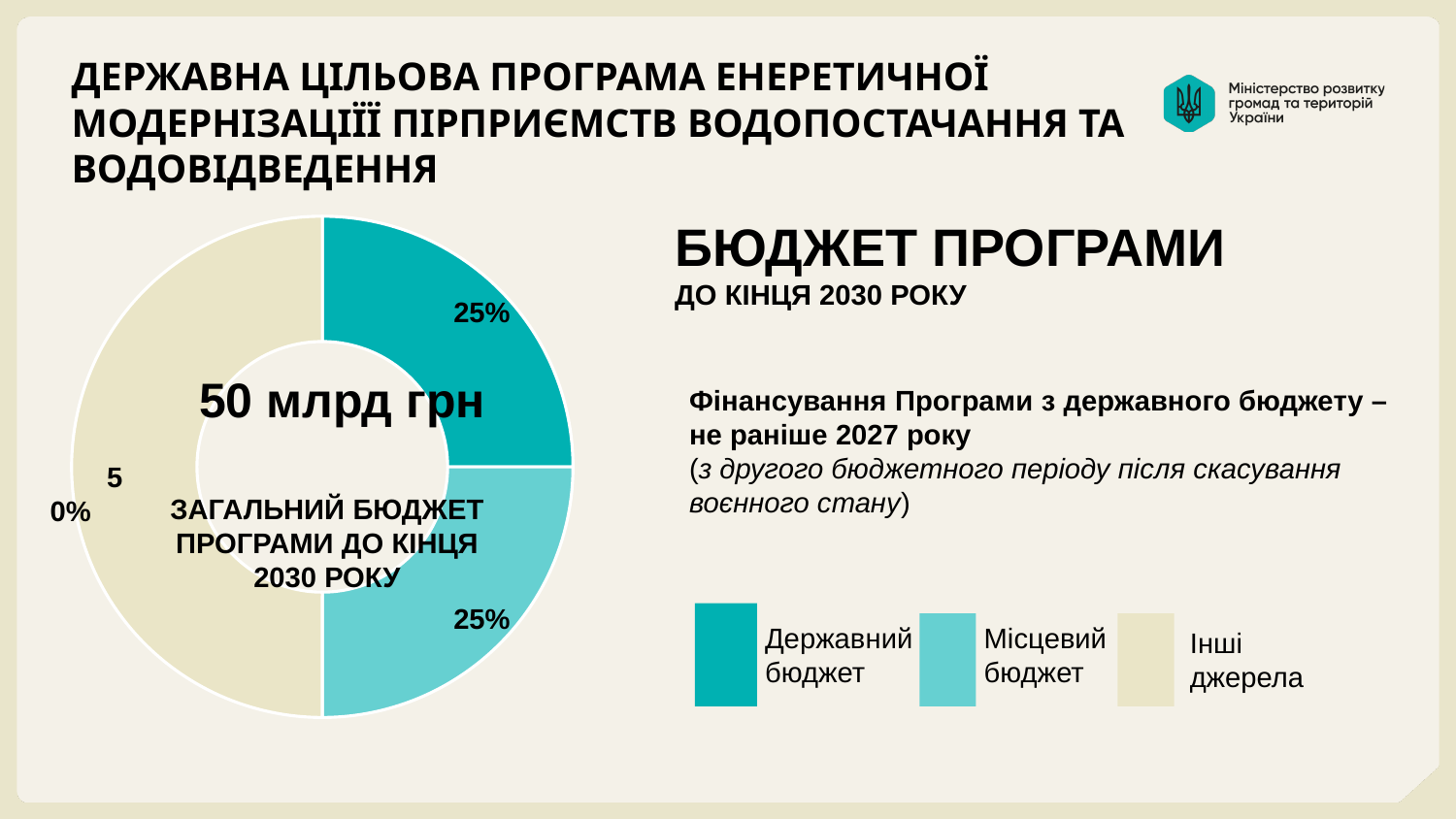
What is the combined share of Державний бюджет and Місцевий бюджет? 50% Which is larger: the share for Інші джерела or the share for Державний бюджет? Інші джерела What share of the programme budget comes from Місцевий бюджет? 25% By how many percentage points does the share for Інші джерела exceed the share for Державний бюджет? 25% How many slices does the donut chart have? 3 What share of the programme budget comes from Інші джерела? 50% Which funding source has the largest share of the programme budget? Інші джерела How many entries does the legend list? 3 What total budget amount is printed in the centre of the donut chart? 50 млрд грн What kind of chart is shown on the slide? pie chart (donut) What share of the programme budget comes from Державний бюджет? 25% Which legend entry is shown in the darkest teal colour? Державний бюджет